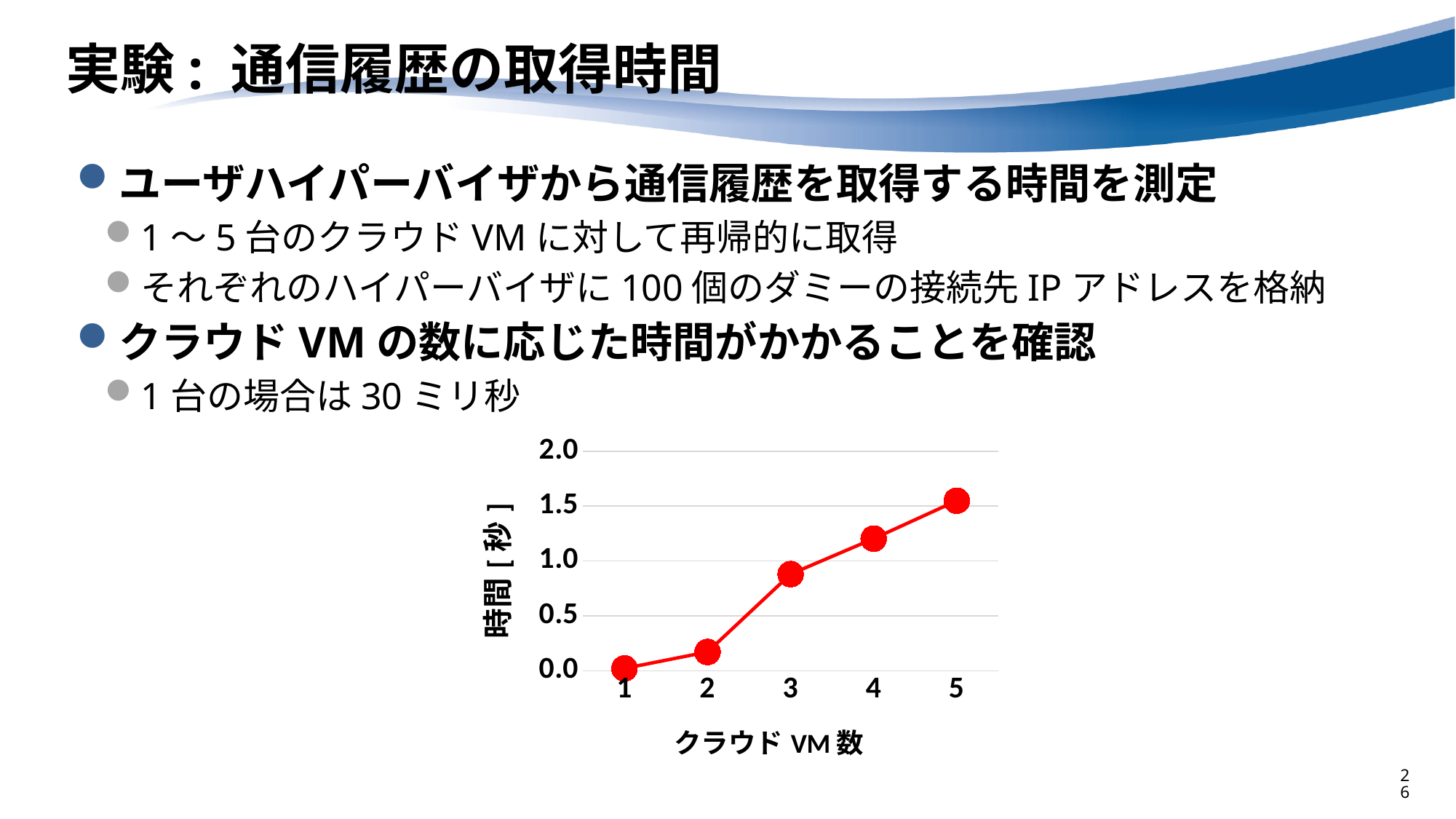
What is the label of the x axis of the chart? クラウドVM数 What kind of chart is shown on the slide? line chart Is the value for 2 cloud VMs greater or less than 0.5? less Is the value for 4 cloud VMs greater or less than 1.0? greater Which cloud VM count has the highest time value? 5 Which is larger, the value for 3 cloud VMs or the value for 4 cloud VMs? 4 cloud VMs Do the values rise or fall as the number of cloud VMs (クラウドVM数) increases from 1 to 5? rise Is the value for 3 cloud VMs greater or less than 1.0? less Which cloud VM count has the lowest time value? 1 What is the label of the y axis of the chart? 時間 [秒] How many data points are plotted on the chart? 5